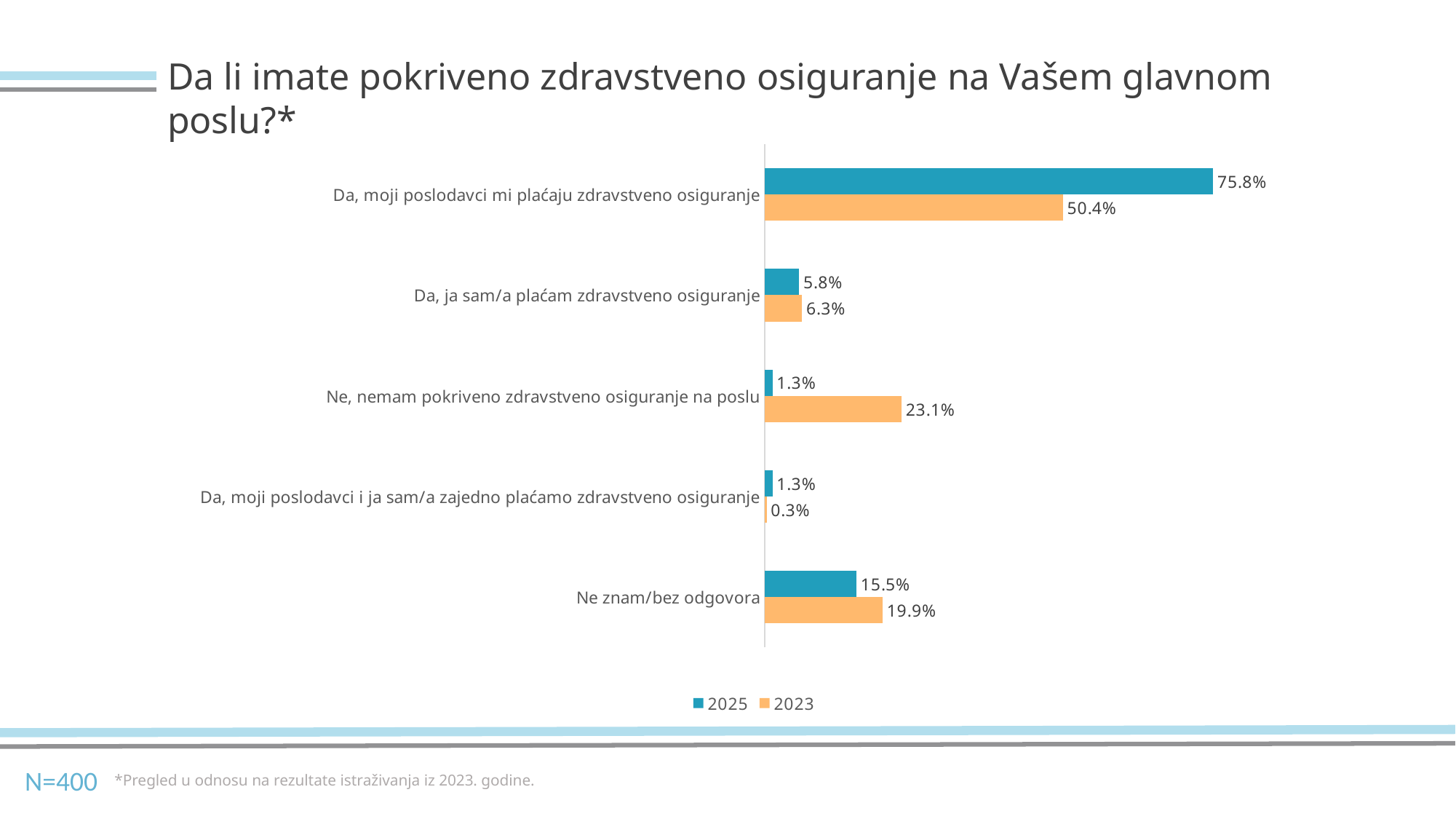
What is the 2025 value for "Da, moji poslodavci mi plaćaju zdravstveno osiguranje"? 75.8% Which series is shown in orange in the legend? 2023 What kind of chart is shown on the slide? Bar chart How many series does the legend list? 2 What is the 2023 value for "Ne, nemam pokriveno zdravstveno osiguranje na poslu"? 23.1% Which category has the lowest 2023 value? Da, moji poslodavci i ja sam/a zajedno plaćamo zdravstveno osiguranje What is the difference between the 2025 and 2023 values for "Da, moji poslodavci mi plaćaju zdravstveno osiguranje"? 25.4% How many categories are shown on the chart? 5 Which is larger for "Da, ja sam/a plaćam zdravstveno osiguranje": the 2025 value or the 2023 value? 2023 What is the difference between the 2023 and 2025 values for "Ne, nemam pokriveno zdravstveno osiguranje na poslu"? 21.8% Which category has the highest 2025 value? Da, moji poslodavci mi plaćaju zdravstveno osiguranje What is the 2023 value for "Ne znam/bez odgovora"? 19.9%